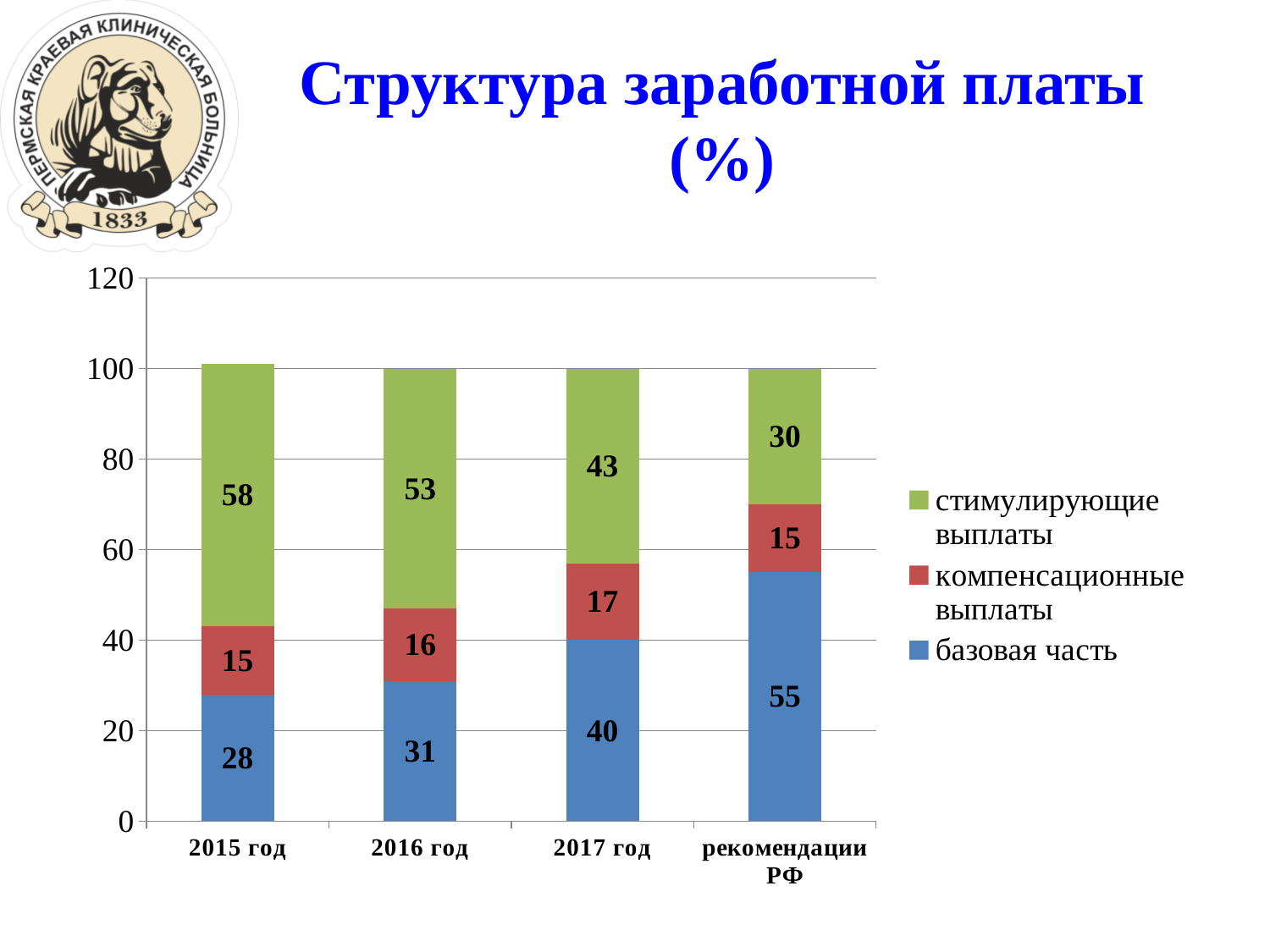
How many categories are shown on the x axis? 4 What is the value of базовая часть for 2017 год? 40 Which category has the lowest value for стимулирующие выплаты? рекомендации РФ What is the difference between стимулирующие выплаты in 2015 год and 2017 год? 15 Which category has the highest value for базовая часть? рекомендации РФ Which is larger: базовая часть in 2016 год or компенсационные выплаты in 2017 год? базовая часть in 2016 год What type of chart is shown on the slide? stacked bar chart What is the value of компенсационные выплаты for рекомендации РФ? 15 What is the value of стимулирующие выплаты for 2015 год? 58 Does the value of базовая часть rise or fall from 2015 год to 2017 год? rise How many series does the legend list? 3 What is the total of the stacked bar for 2017 год? 100